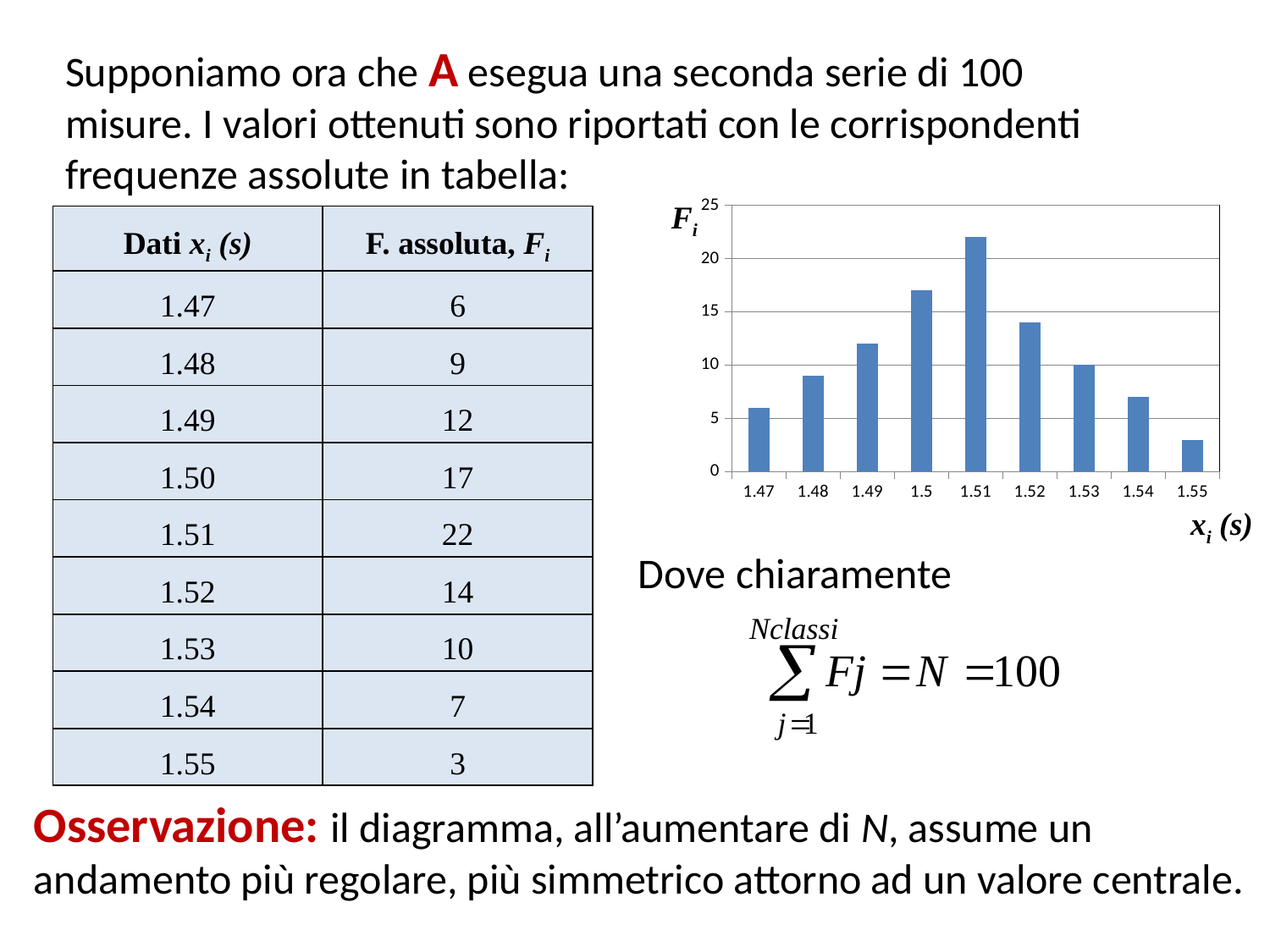
What is the absolute frequency F_i for x_i = 1.53? 10 Which x_i value has the highest absolute frequency F_i in the chart? 1.51 Which has a higher absolute frequency, x_i = 1.49 or x_i = 1.52? 1.52 Is the bar for x_i = 1.5 greater or less than 15? greater Which x_i value has the lowest absolute frequency F_i in the chart? 1.55 What is the absolute frequency F_i for x_i = 1.47? 6 What is the absolute frequency F_i for x_i = 1.51? 22 Do the bar heights rise or fall from x_i = 1.51 to x_i = 1.55? fall Is the bar for x_i = 1.55 greater or less than 5? less What is the difference between the absolute frequencies for x_i = 1.51 and x_i = 1.50? 5 How many categories (x_i values) are plotted on the x axis of the chart? 9 What kind of chart is shown on the slide? bar chart